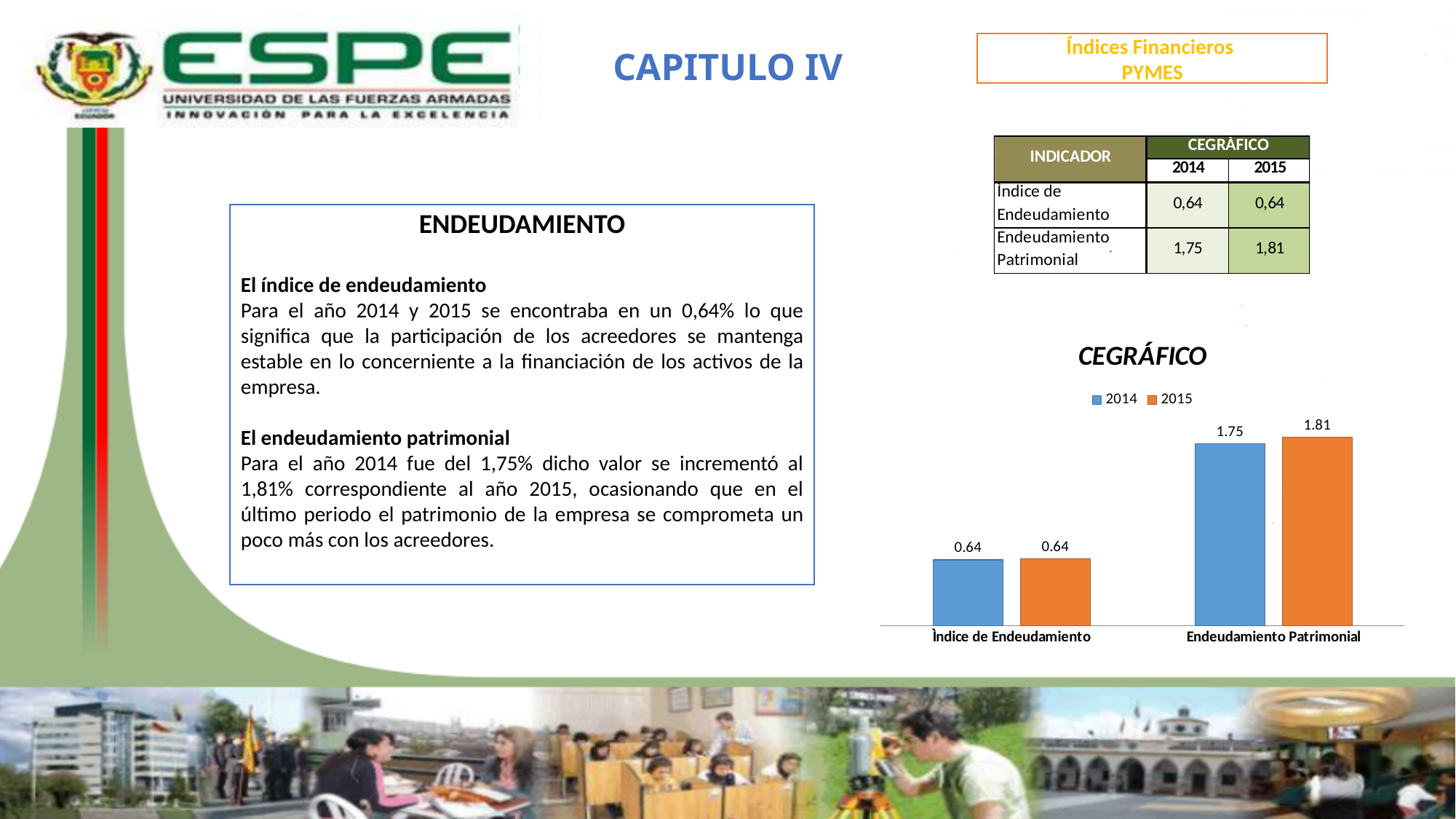
What is the value for Ìndice de Endeudamiento in 2015? 0.64 Which category has the lowest value in the 2014 series? Ìndice de Endeudamiento Which is larger for Endeudamiento Patrimonial, the 2014 value or the 2015 value? 2015 What is the value for Endeudamiento Patrimonial in 2015? 1.81 How many series does the chart legend list? 2 What kind of chart is shown on the slide? Bar chart How many categories are shown on the x axis of the chart? 2 What is the title of the chart? CEGRÁFICO What is the value for Ìndice de Endeudamiento in 2014? 0.64 What is the difference between the 2015 and 2014 values for Endeudamiento Patrimonial? 0.06 Which category has the highest value in the 2015 series? Endeudamiento Patrimonial What is the value for Endeudamiento Patrimonial in 2014? 1.75